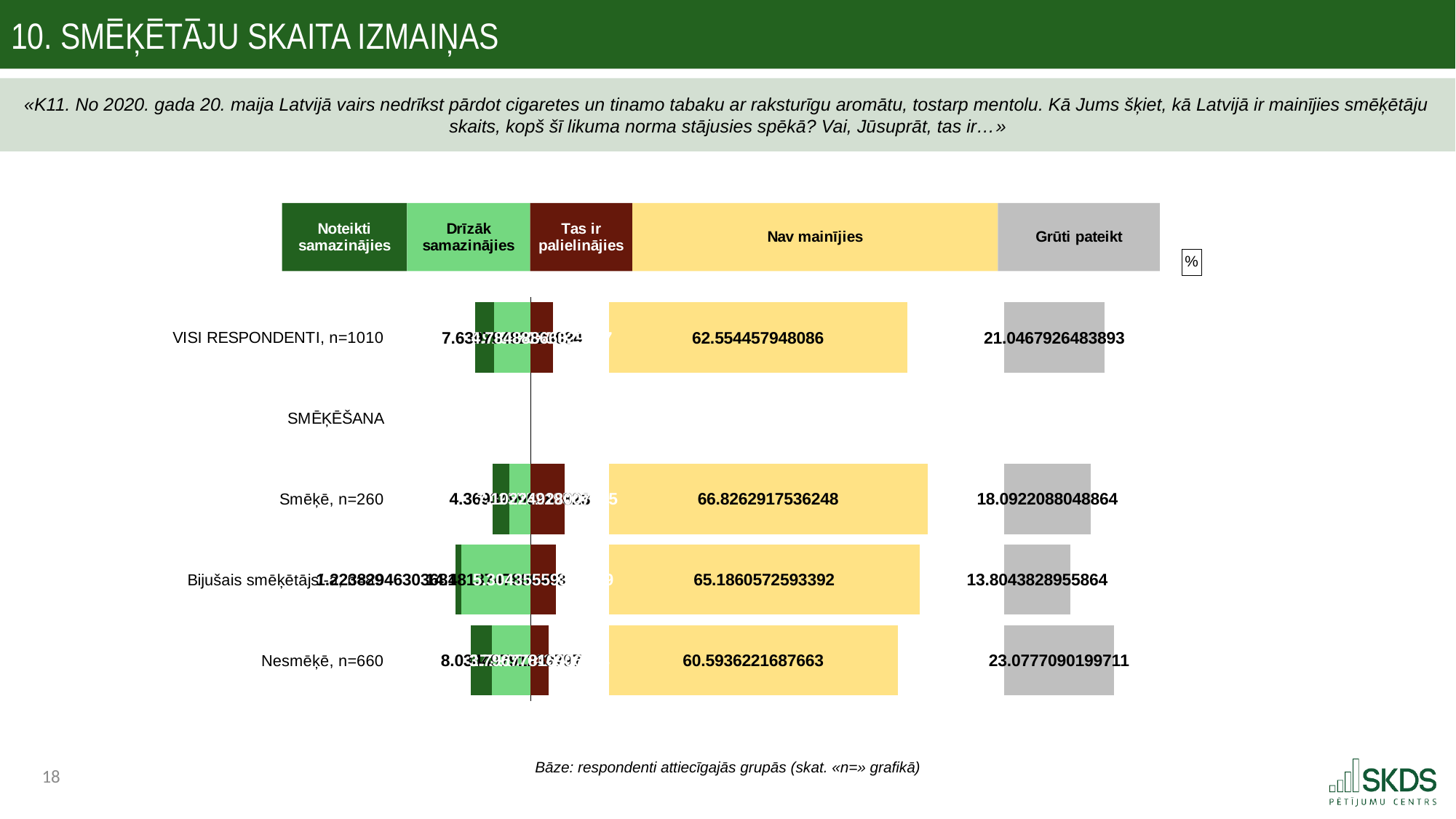
What is the difference between the 'Grūti pateikt' values for Nesmēķē, n=660 and Bijušais smēķētājs? 9.2733261243847 What is the value of 'Nav mainījies' for VISI RESPONDENTI, n=1010? 62.554457948086 How many respondent groups (bars) are plotted in the chart? 4 What is the value of 'Grūti pateikt' for Smēķē, n=260? 18.0922088048864 Which respondent group has the lowest 'Grūti pateikt' value? Bijušais smēķētājs How many series does the chart legend list? 5 Which is larger: the 'Nav mainījies' value for Nesmēķē, n=660 or for Smēķē, n=260? Smēķē, n=260 What is the value of 'Nav mainījies' for Bijušais smēķētājs? 65.1860572593392 Which respondent group has the highest 'Nav mainījies' value? Smēķē, n=260 Which legend entry is shown in yellow? Nav mainījies What kind of chart is shown on the slide? Stacked bar chart What is the value of 'Grūti pateikt' for Nesmēķē, n=660? 23.0777090199711